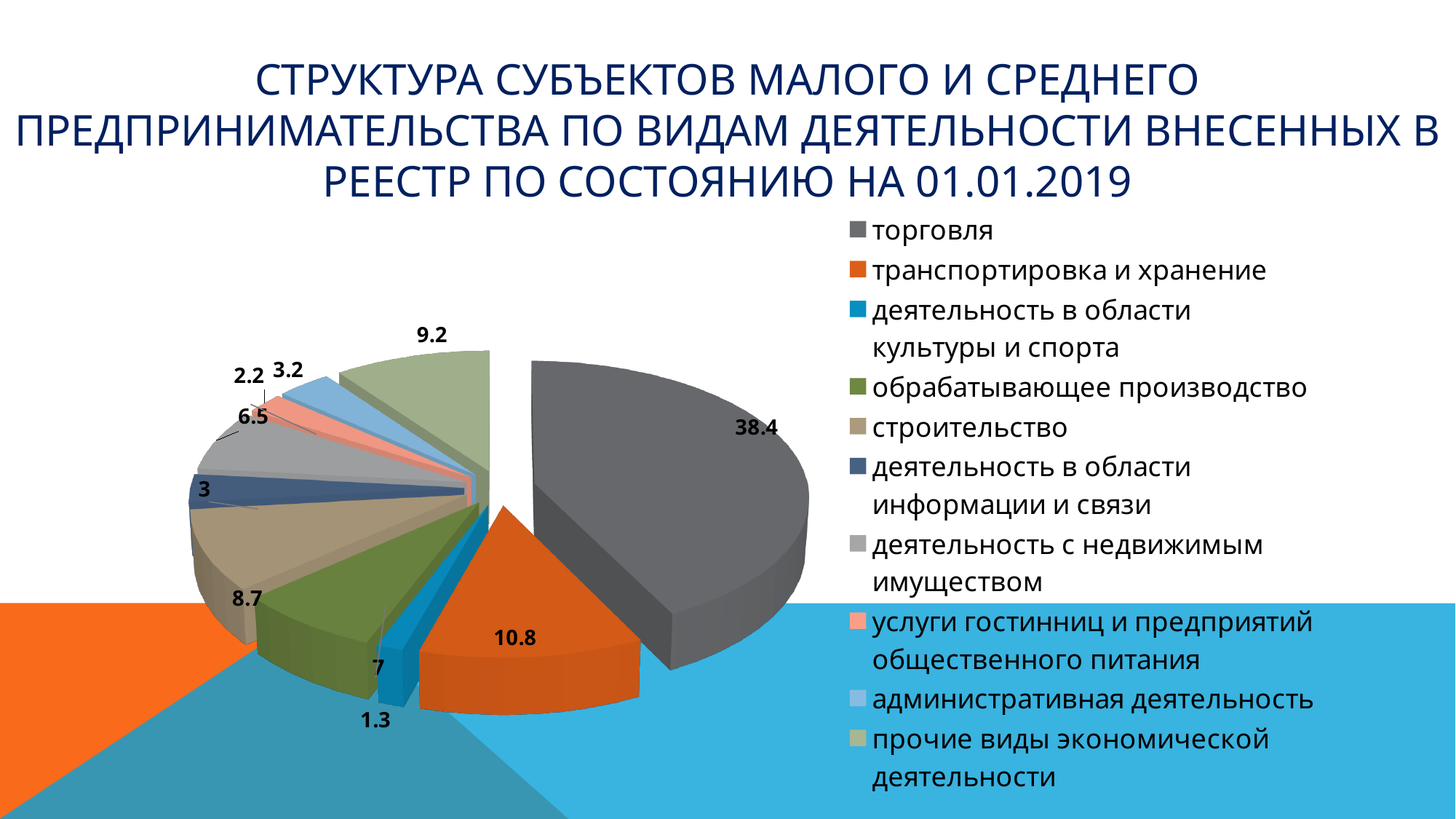
What is the value for строительство? 8.7 What is the value for транспортировка и хранение? 10.8 How many categories does the legend list? 10 Which category has the largest slice? торговля What is the value for деятельность в области культуры и спорта? 1.3 Which is larger, the value for обрабатывающее производство or the value for строительство? строительство What is the difference between the values for торговля and транспортировка и хранение? 27.6 What is the value for прочие виды экономической деятельности? 9.2 Which category has the smallest slice? деятельность в области культуры и спорта What kind of chart is shown on the slide? pie chart What date is given in the chart title? 01.01.2019 What is the value for торговля? 38.4